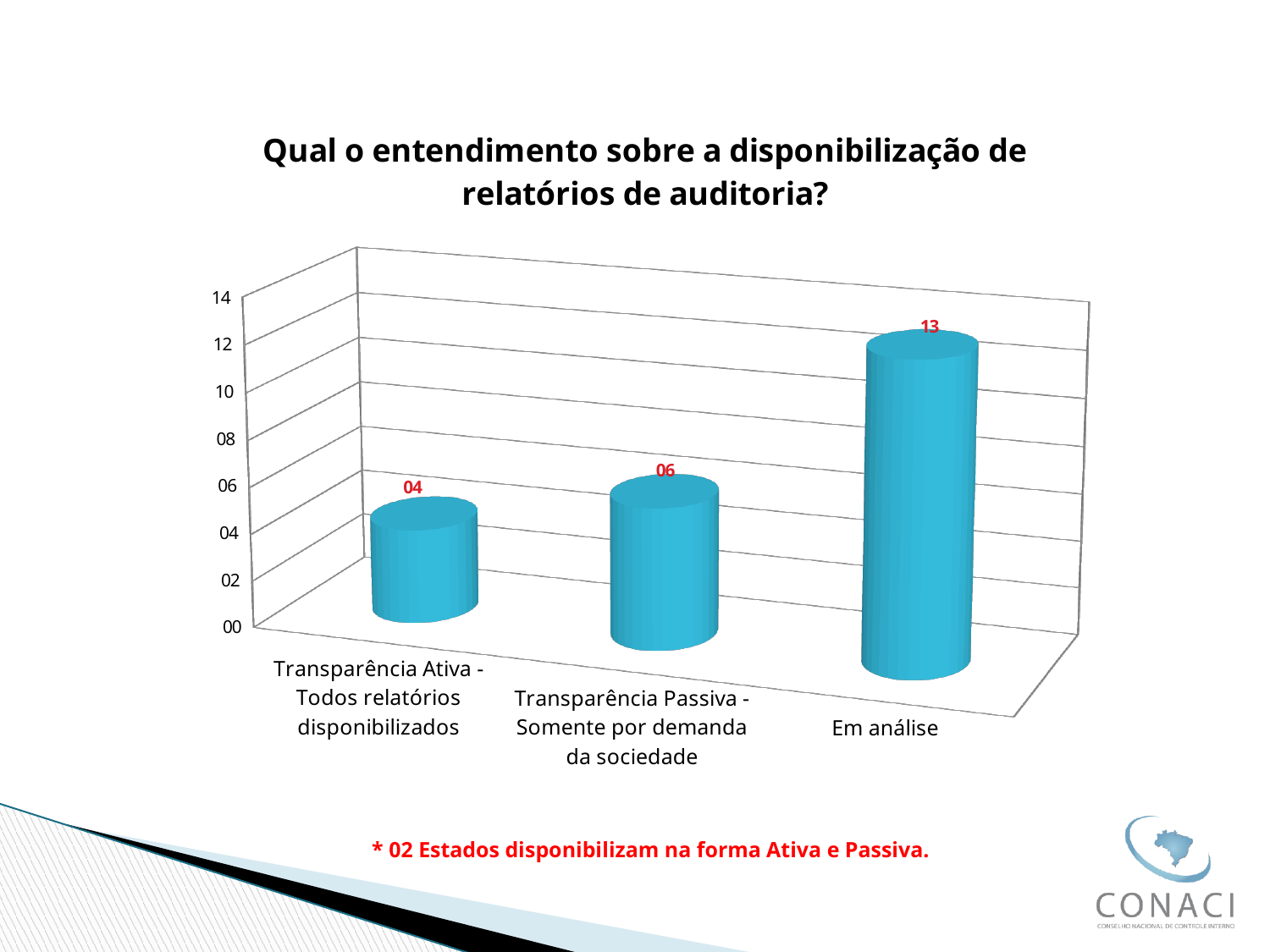
Is the value for "Em análise" greater or less than 10? greater What is the difference between the values for "Em análise" and "Transparência Passiva - Somente por demanda da sociedade"? 7 What is the value for "Transparência Passiva - Somente por demanda da sociedade"? 06 What is the value for "Em análise"? 13 What kind of chart is shown on the slide? bar chart What is the difference between the values for "Transparência Passiva - Somente por demanda da sociedade" and "Transparência Ativa - Todos relatórios disponibilizados"? 2 How many categories are shown in the chart? 3 What is the value for "Transparência Ativa - Todos relatórios disponibilizados"? 04 Which category has the lowest value? Transparência Ativa - Todos relatórios disponibilizados Which is larger: the value for "Transparência Ativa - Todos relatórios disponibilizados" or for "Transparência Passiva - Somente por demanda da sociedade"? Transparência Passiva - Somente por demanda da sociedade Which category has the highest value? Em análise What is the title of the chart? Qual o entendimento sobre a disponibilização de relatórios de auditoria?